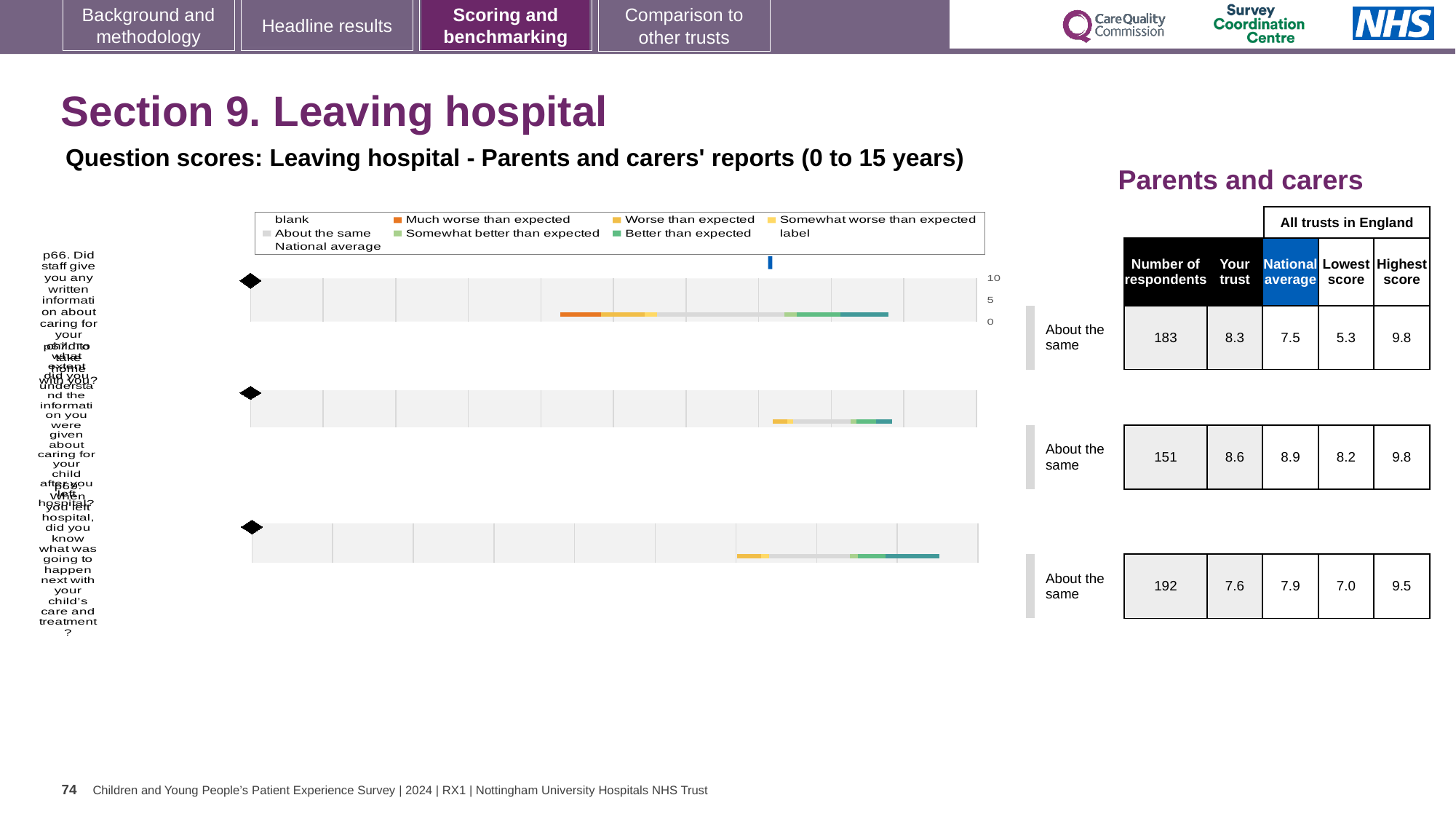
What is the heading above the table on the right of the slide? Parents and carers In the table, what is the number of respondents for the top row? 183 In the table, what is the national average for the middle row? 8.9 In the bottom row of the table, is the 'Your trust' score or the national average larger? National average In the table, what is the highest score for the middle row? 9.8 What benchmark category is shown next to each of the three charts? About the same What kind of chart is used to show the question scores on this slide? bar chart What is the difference between the 'Your trust' score and the national average in the top row of the table? 0.8 Which row of the table has the highest number of respondents? the bottom row (192) In the table, what is the lowest score for the bottom row? 7.0 How many question charts are shown on the slide? 3 In the table, what is the 'Your trust' score for the top row? 8.3